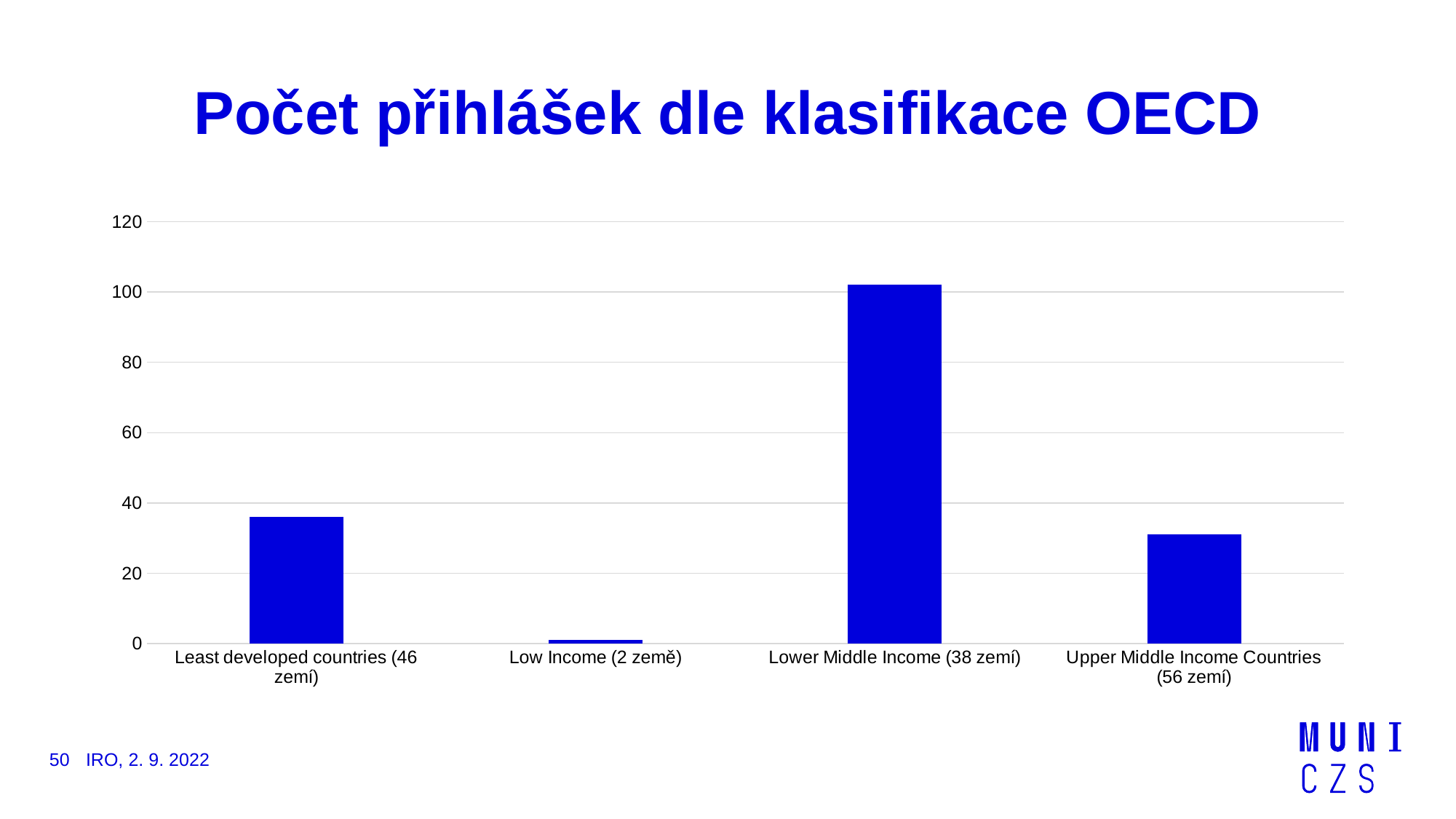
What is the highest value shown on the y axis of the chart? 120 Is the value for Low Income (2 země) greater or less than 20? less Which category has the lowest value in the chart? Low Income (2 země) Which category has the highest value in the chart? Lower Middle Income (38 zemí) Which is larger: the value for Lower Middle Income (38 zemí) or the value for Upper Middle Income Countries (56 zemí)? Lower Middle Income (38 zemí) What is the title of the chart? Počet přihlášek dle klasifikace OECD Is the value for Lower Middle Income (38 zemí) greater or less than 80? greater What type of chart is shown on the slide? bar chart How many categories are shown on the x axis of the chart? 4 Is the value for Least developed countries (46 zemí) greater or less than 40? less Which is larger: the value for Least developed countries (46 zemí) or the value for Upper Middle Income Countries (56 zemí)? Least developed countries (46 zemí)